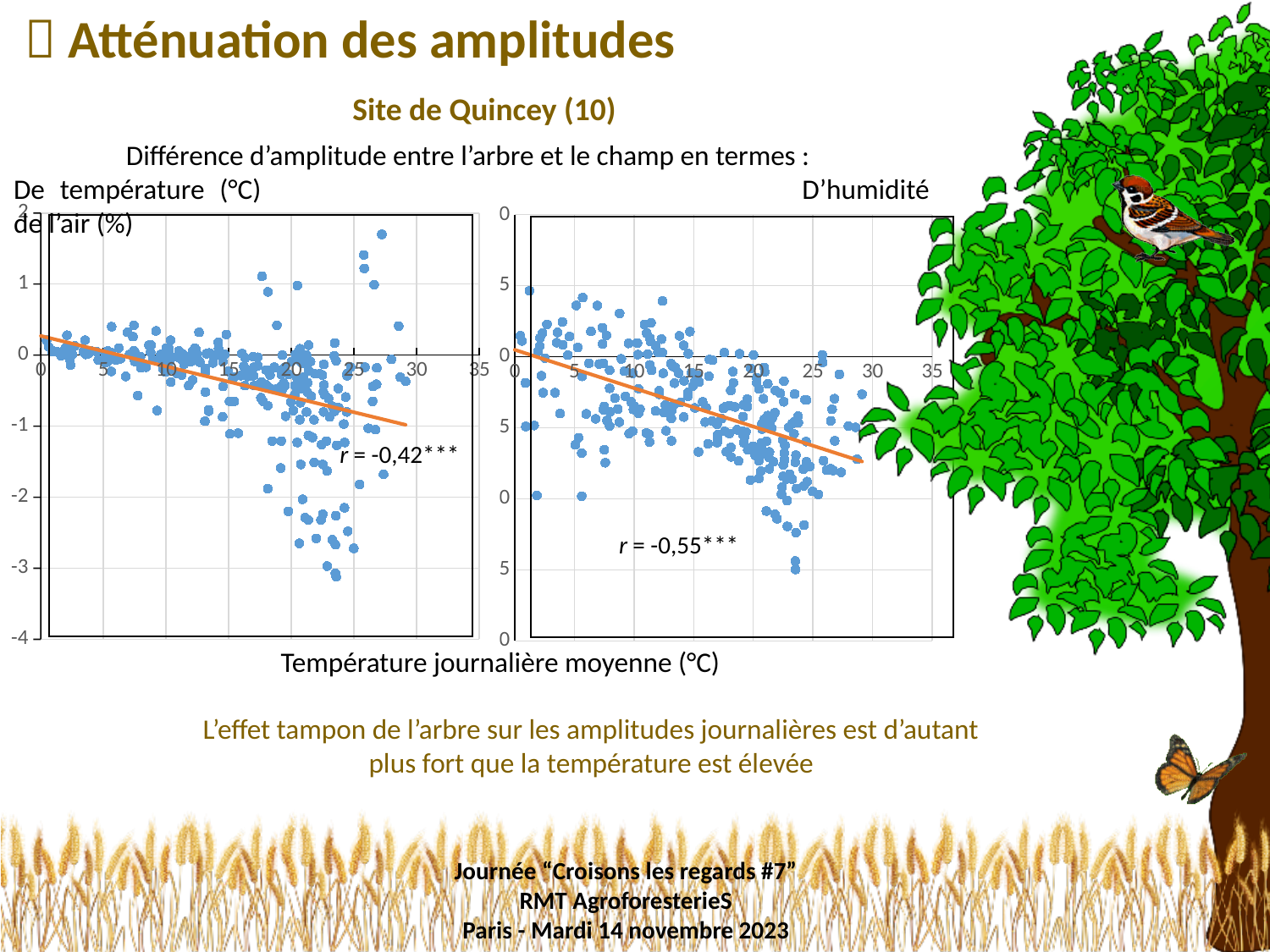
What kind of chart is the right chart (D'humidité de l'air (%))? scatter chart On the left chart (De température (°C)), does the fitted trend line rise or fall as the mean daily temperature increases? fall Which chart shows the stronger (more negative) correlation coefficient, the left temperature chart or the right humidity chart? the right humidity chart On the right chart (D'humidité de l'air (%)), does the fitted trend line rise or fall as the mean daily temperature increases? fall What is the difference between the two printed correlation coefficients, -0,55 and -0,42, in absolute value? 0,13 What is the lowest tick value shown on the y axis of the left chart (De température (°C))? -4 What kind of chart is the left chart (De température (°C))? scatter chart On the right chart (D'humidité de l'air (%)), what correlation coefficient r is printed? r = -0,55*** On the left chart (De température (°C)), what correlation coefficient r is printed? r = -0,42*** What is the highest tick value shown on the x axis of the left chart (De température (°C))? 35 What is the shared x-axis label printed below the two charts? Température journalière moyenne (°C)